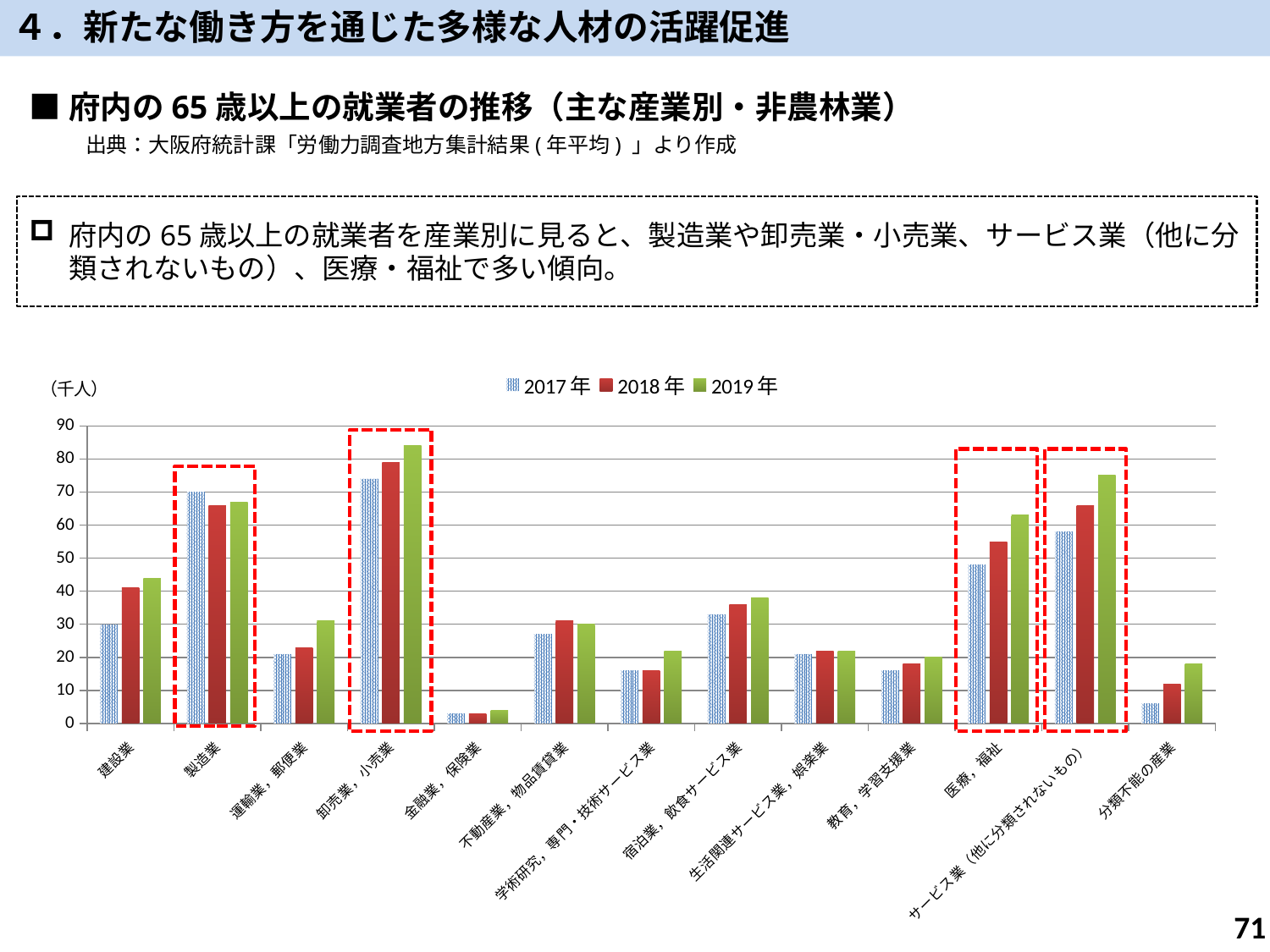
Is the 2018年 value for 製造業 greater or less than 60? greater For 2019年, which is larger: 医療，福祉 or サービス業（他に分類されないもの）? サービス業（他に分類されないもの） Do the values for 卸売業，小売業 rise or fall from 2017年 to 2019年? rise How many industry categories are shown on the x axis? 13 Which industry has the highest bar in the chart? 卸売業，小売業 What kind of chart is shown on the slide? bar chart Is the 2019年 value for 金融業，保険業 greater or less than 10? less How many series does the legend list? 3 Is the 2019年 value for 医療，福祉 greater or less than 60? greater What is the 2017年 value for 製造業? 70 Which industry has the lowest bars in the chart? 金融業，保険業